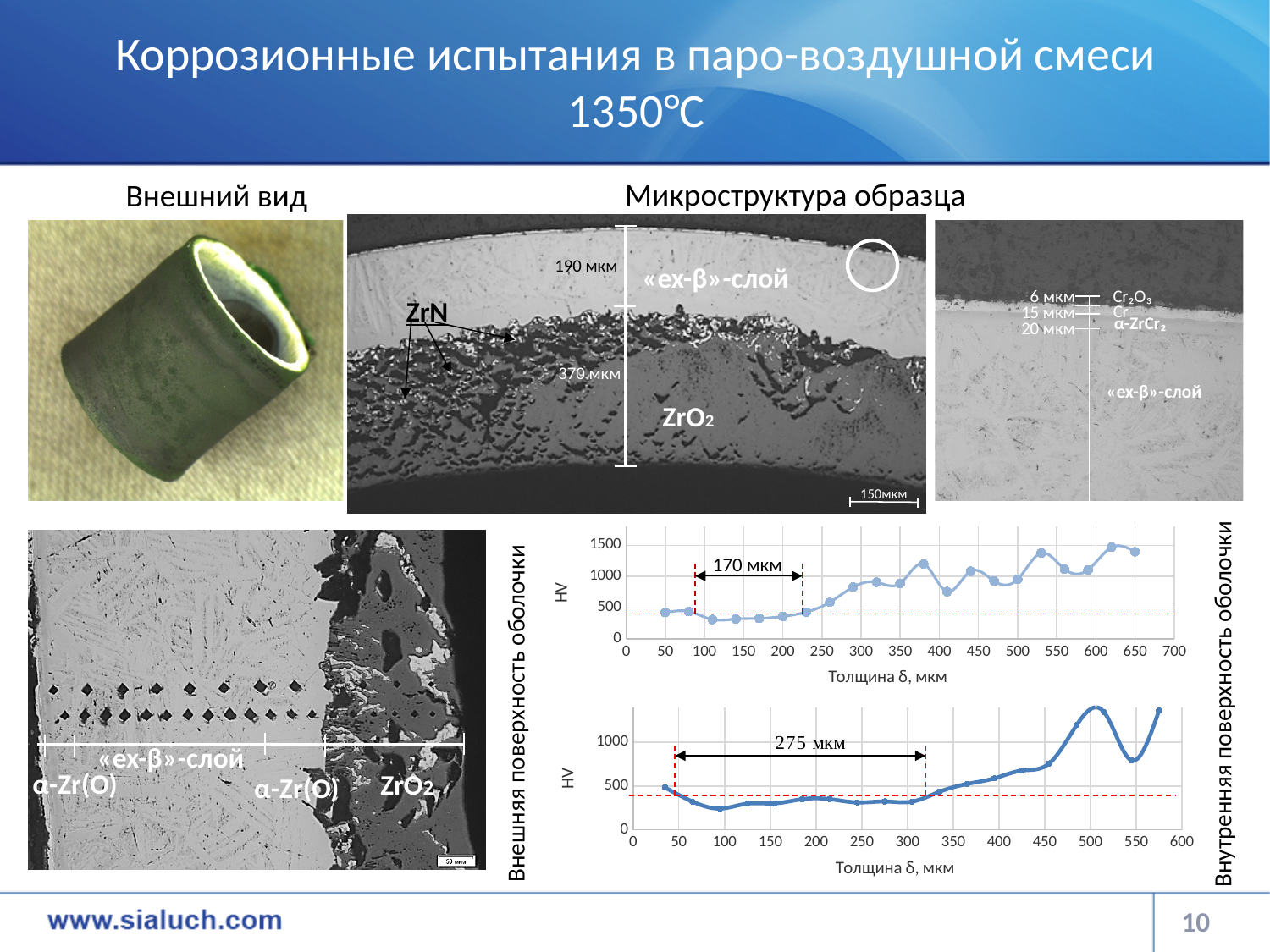
What is the largest tick value shown on the x axis of the lower HV chart? 600 In the upper HV chart, is the value at a thickness of 600 мкм greater or less than 1000? greater In the upper HV chart, what width is indicated by the labelled arrow between the dashed lines? 170 мкм In the lower HV chart, is the value at a thickness of 100 мкм greater or less than 500? less What kind of chart is the upper chart on the right side of the slide (HV versus thickness)? line chart In the upper HV chart, do the values generally rise or fall as thickness increases from left to right? rise In the lower HV chart, is the value at a thickness of 500 мкм greater or less than 1000? greater In the lower HV chart, what width is indicated by the labelled arrow between the dashed lines? 275 мкм In the lower HV chart, do the values generally rise or fall as thickness increases from left to right? rise What is the x-axis title of the upper HV chart? Толщина δ, мкм What kind of chart is the lower chart on the right side of the slide (HV versus thickness)? line chart